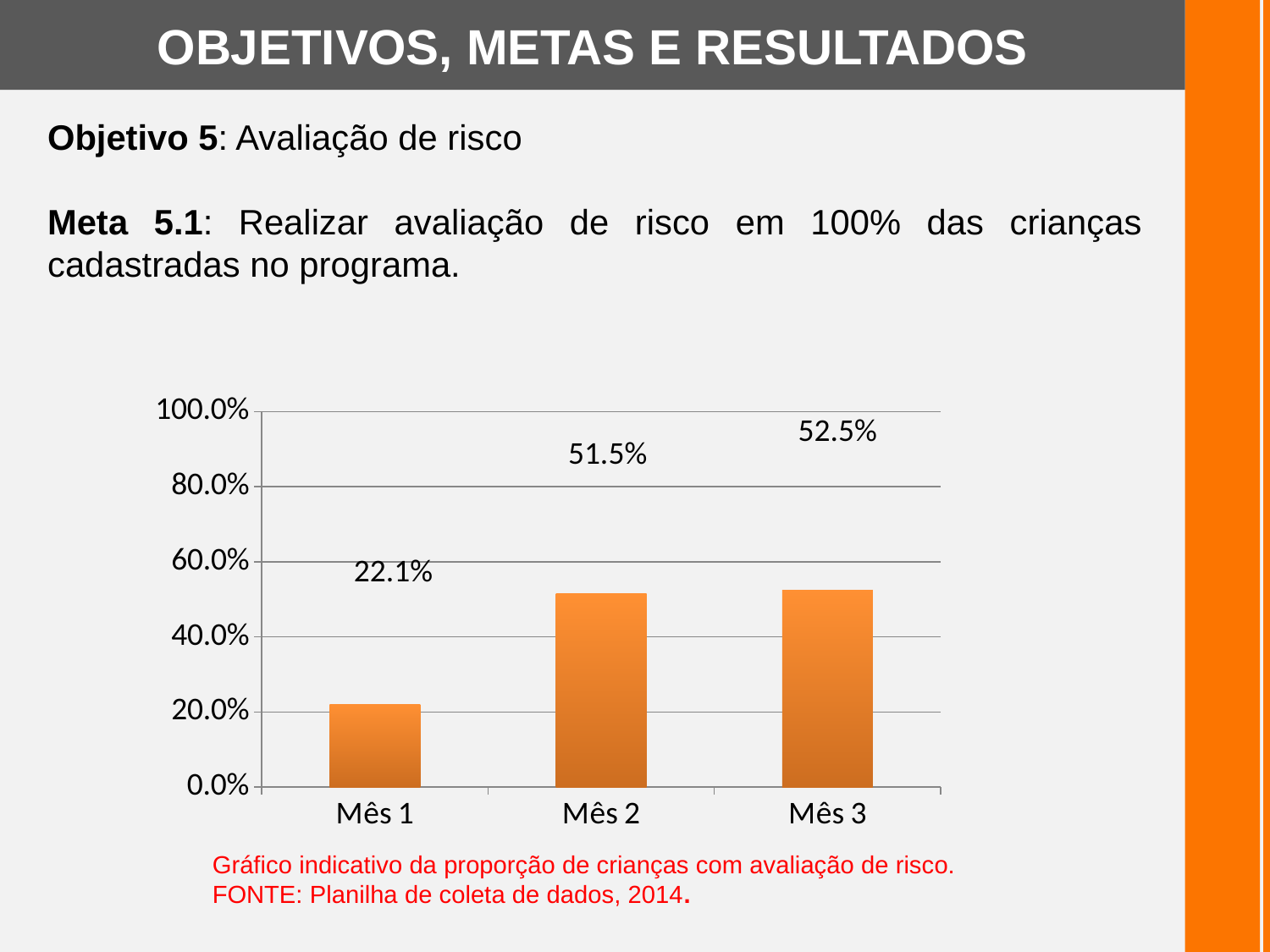
What is the value for Mês 1? 22.1% What is the value for Mês 2? 51.5% Is the value for Mês 1 greater or less than 40.0%? less What kind of chart is shown on the slide? bar chart What is the value for Mês 3? 52.5% Do the values rise or fall from Mês 1 to Mês 3? rise What is the difference between the values for Mês 3 and Mês 2? 1.0% Which month has the lowest value? Mês 1 What is the difference between the values for Mês 2 and Mês 1? 29.4% Which month has the highest value? Mês 3 How many months are shown on the x axis? 3 Which is larger, the value for Mês 1 or the value for Mês 2? Mês 2